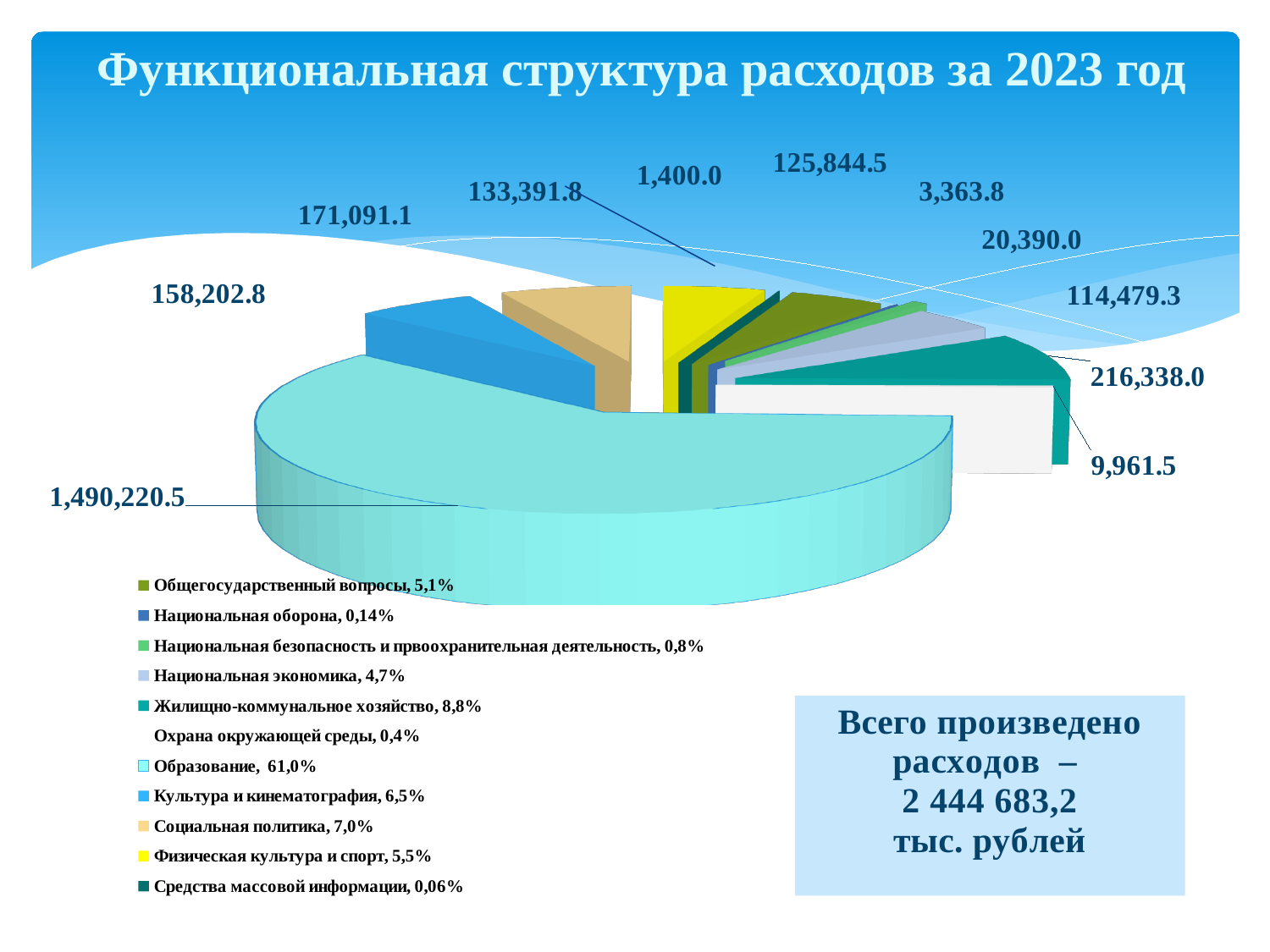
Which category has the smallest share of expenditures in the pie chart? Средства массовой информации What is the total amount of expenditures stated on the slide? 2 444 683,2 тыс. рублей What is the value of the largest slice of the pie chart (Образование)? 1,490,220.5 Which category has the largest share of expenditures in the pie chart? Образование What kind of chart is shown on the slide? pie chart What is the title of the slide? Функциональная структура расходов за 2023 год What is the value of the Жилищно-коммунальное хозяйство slice? 216,338.0 What is the difference in share between Образование and Жилищно-коммунальное хозяйство? 52,2% Which has a larger share: Социальная политика or Культура и кинематография? Социальная политика How many categories does the legend of the pie chart list? 11 What share of expenditures does Жилищно-коммунальное хозяйство account for? 8,8% What share of expenditures does Образование account for? 61,0%